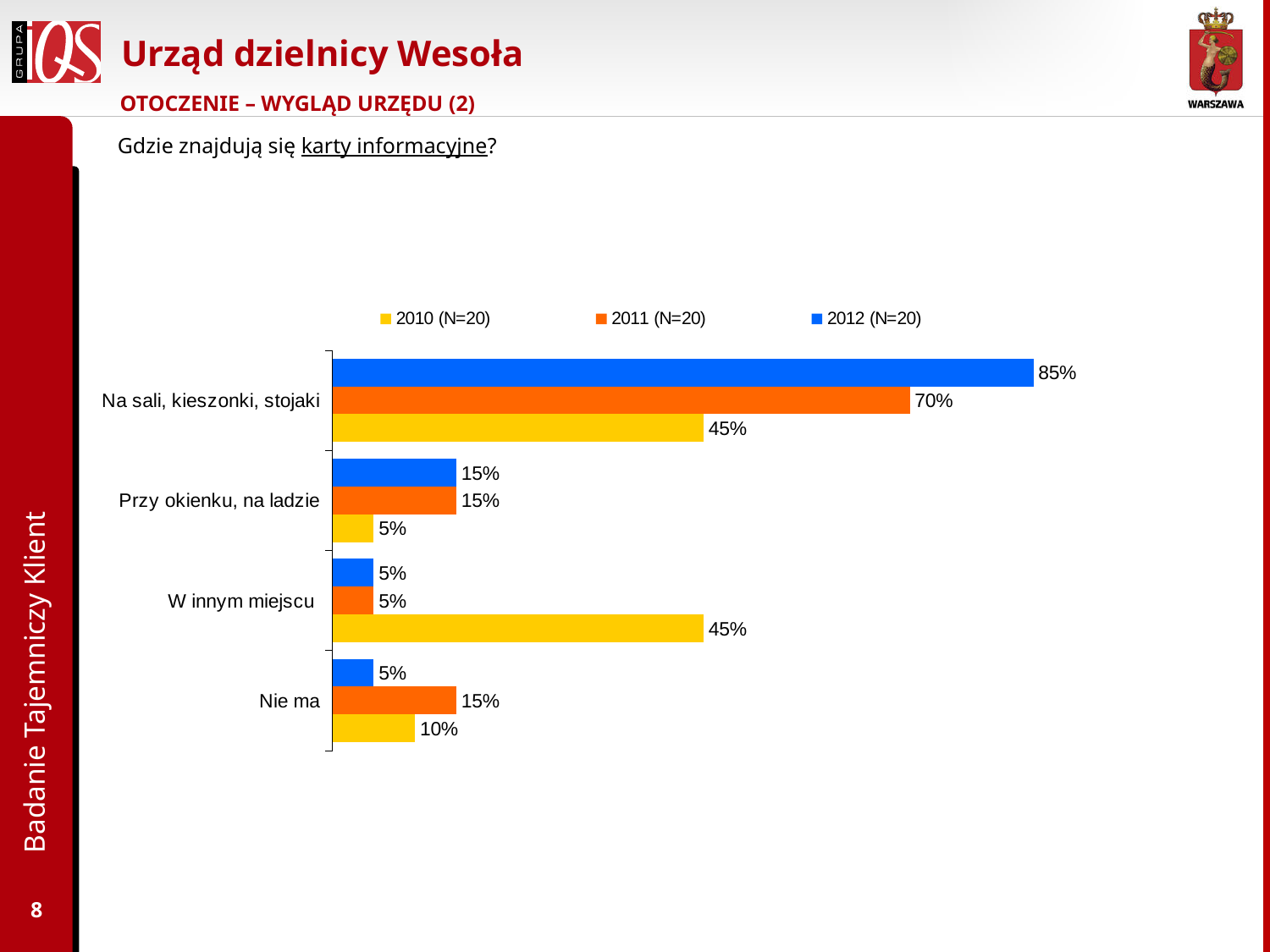
Which colour represents the 2011 (N=20) series in the legend? Orange Which category has the lowest value in the 2010 (N=20) series? Przy okienku, na ladzie What is the value for 'W innym miejscu' in the 2010 (N=20) series? 45% What kind of chart is shown on the slide? Bar chart How many series does the legend list? 3 What is the value for 'Na sali, kieszonki, stojaki' in the 2012 (N=20) series? 85% What is the value for 'Przy okienku, na ladzie' in the 2010 (N=20) series? 5% What is the difference between the 2012 (N=20) and 2010 (N=20) values for 'Na sali, kieszonki, stojaki'? 40% Which is larger for 'W innym miejscu': the 2010 (N=20) value or the 2012 (N=20) value? 2010 (N=20) What is the value for 'Nie ma' in the 2011 (N=20) series? 15% How many categories are shown on the chart? 4 Which category has the highest value in the 2012 (N=20) series? Na sali, kieszonki, stojaki